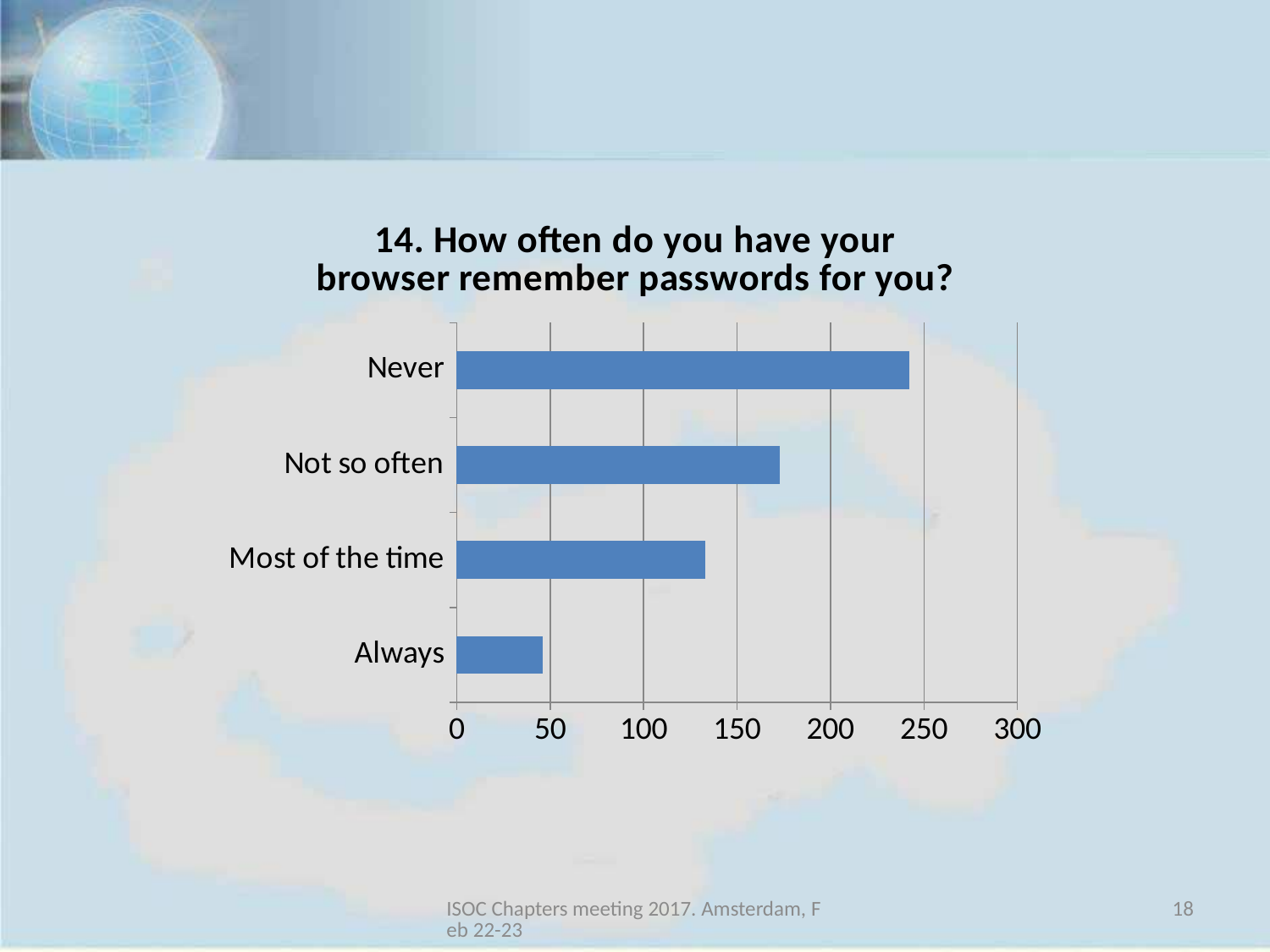
Is the value for Always greater or less than 100? less How many categories are shown in the chart? 4 Is the value for Not so often greater or less than 150? greater Is the value for Never greater or less than 200? greater Which category has the highest value? Never What is the title of the chart? 14. How often do you have your browser remember passwords for you? Which is larger, the value for Never or the value for Not so often? Never Which is larger, the value for Most of the time or the value for Always? Most of the time Which category has the lowest value? Always What kind of chart is shown on the slide? bar chart